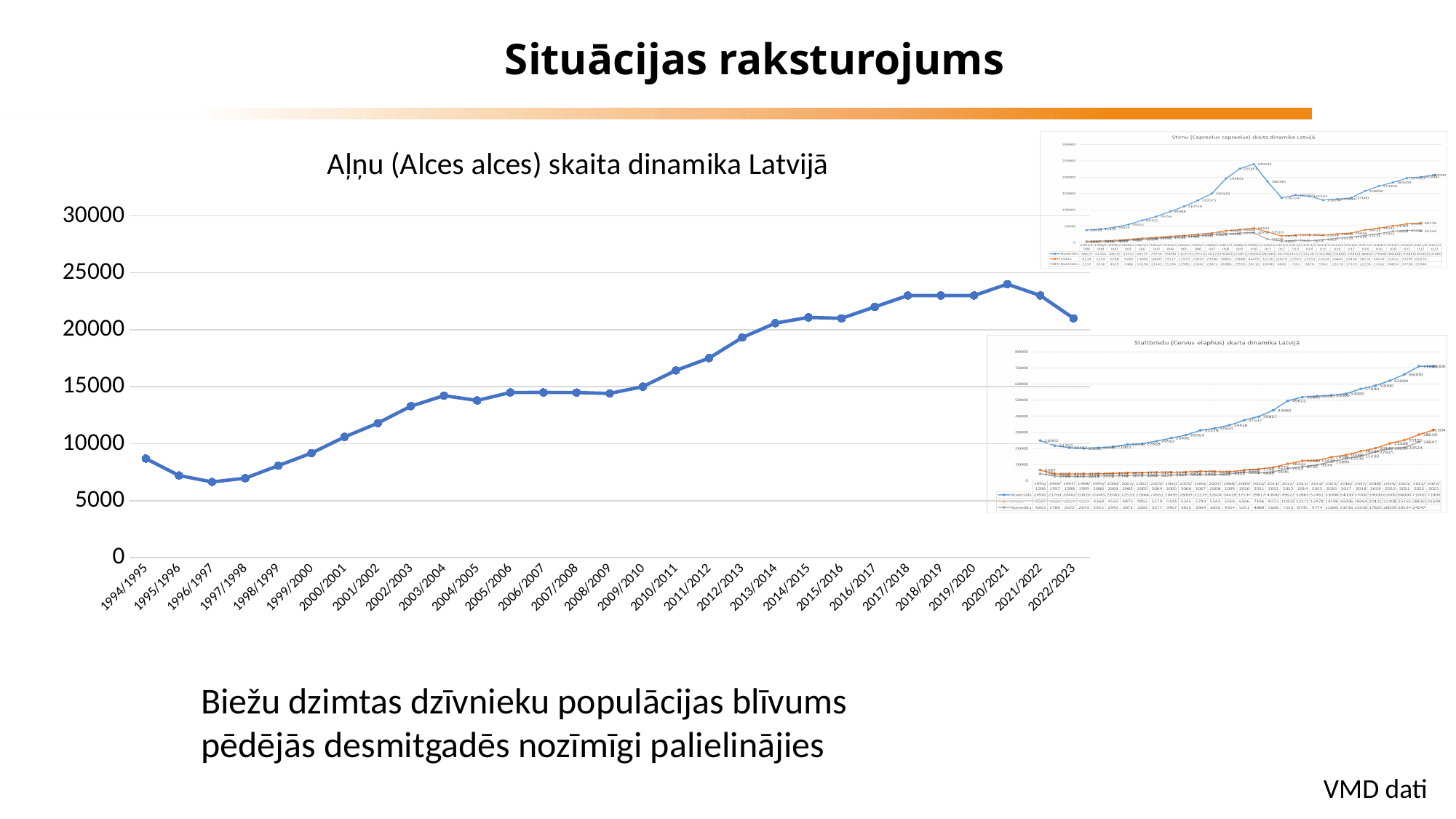
How many charts are shown on the slide? 3 In the 'Aļņu (Alces alces) skaita dinamika Latvijā' chart, which season has the larger value, 2013/2014 or 2017/2018? 2017/2018 In the 'Aļņu (Alces alces) skaita dinamika Latvijā' chart, which season has the highest value? 2020/2021 In the 'Aļņu (Alces alces) skaita dinamika Latvijā' chart, is the value for 1994/1995 greater or less than 10000? less In the 'Aļņu (Alces alces) skaita dinamika Latvijā' chart, is the value for 2020/2021 greater or less than 20000? greater In the 'Aļņu (Alces alces) skaita dinamika Latvijā' chart, is the value for 2010/2011 greater or less than 15000? greater In the 'Aļņu (Alces alces) skaita dinamika Latvijā' chart, do the values overall rise or fall from 1994/1995 to 2022/2023? rise What kind of chart is the 'Aļņu (Alces alces) skaita dinamika Latvijā' chart? line chart In the 'Aļņu (Alces alces) skaita dinamika Latvijā' chart, which season has the larger value, 1994/1995 or 2022/2023? 2022/2023 In the 'Aļņu (Alces alces) skaita dinamika Latvijā' chart, how many seasons are plotted along the x axis? 29 In the 'Aļņu (Alces alces) skaita dinamika Latvijā' chart, which season has the lowest value? 1996/1997